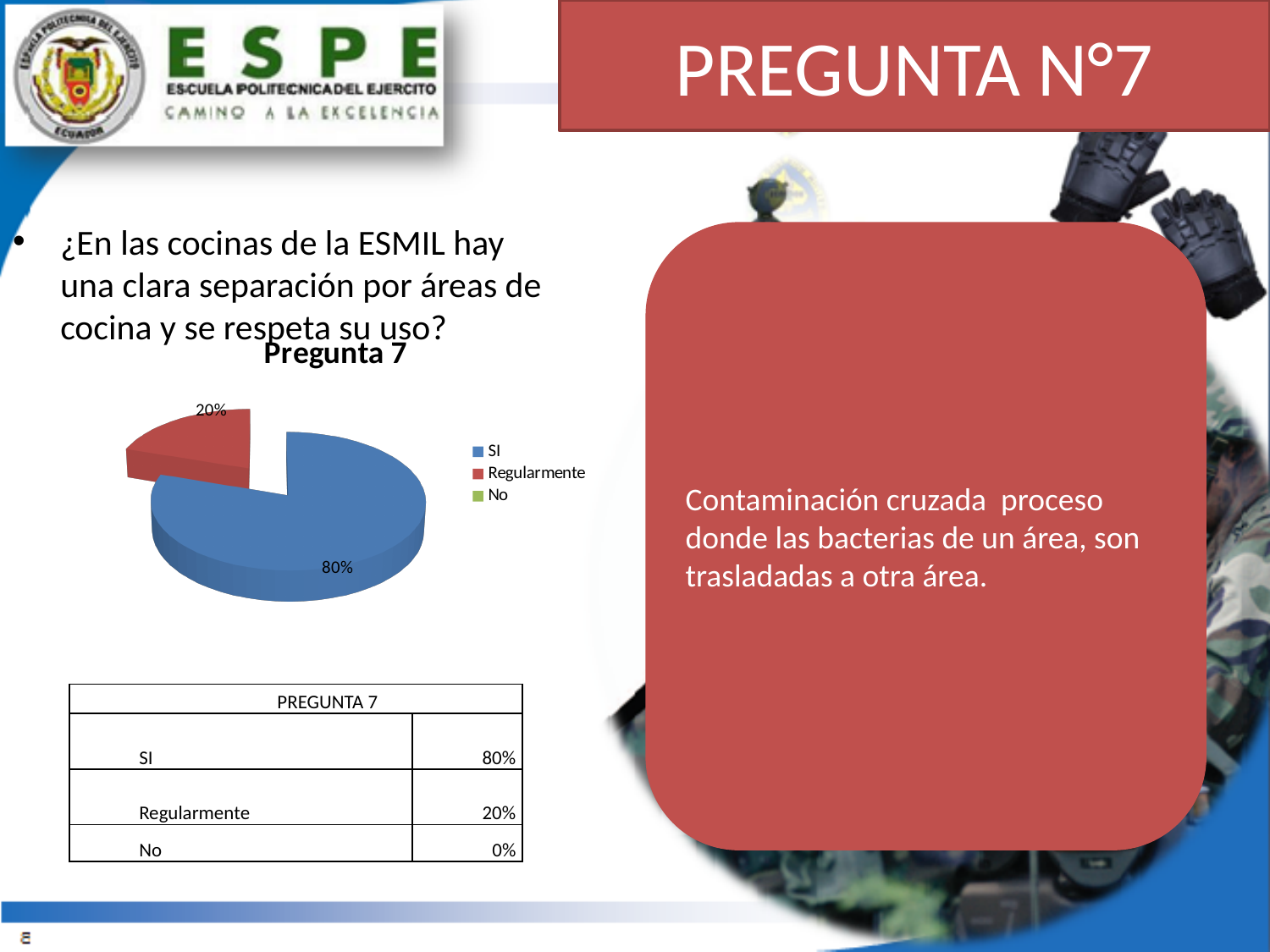
How many entries does the legend list? 3 Which is larger, the SI slice or the Regularmente slice? SI What kind of chart is shown on the slide? pie chart Is the share for SI greater or less than 50%? greater What share of the pie does the SI slice represent? 80% What is the difference between the SI share and the Regularmente share? 60% Which category has the largest slice of the pie? SI What colour is the SI slice in the pie chart? blue According to the table below the chart, what is the value for No? 0% What share of the pie does the Regularmente slice represent? 20% What is the chart's title? Pregunta 7